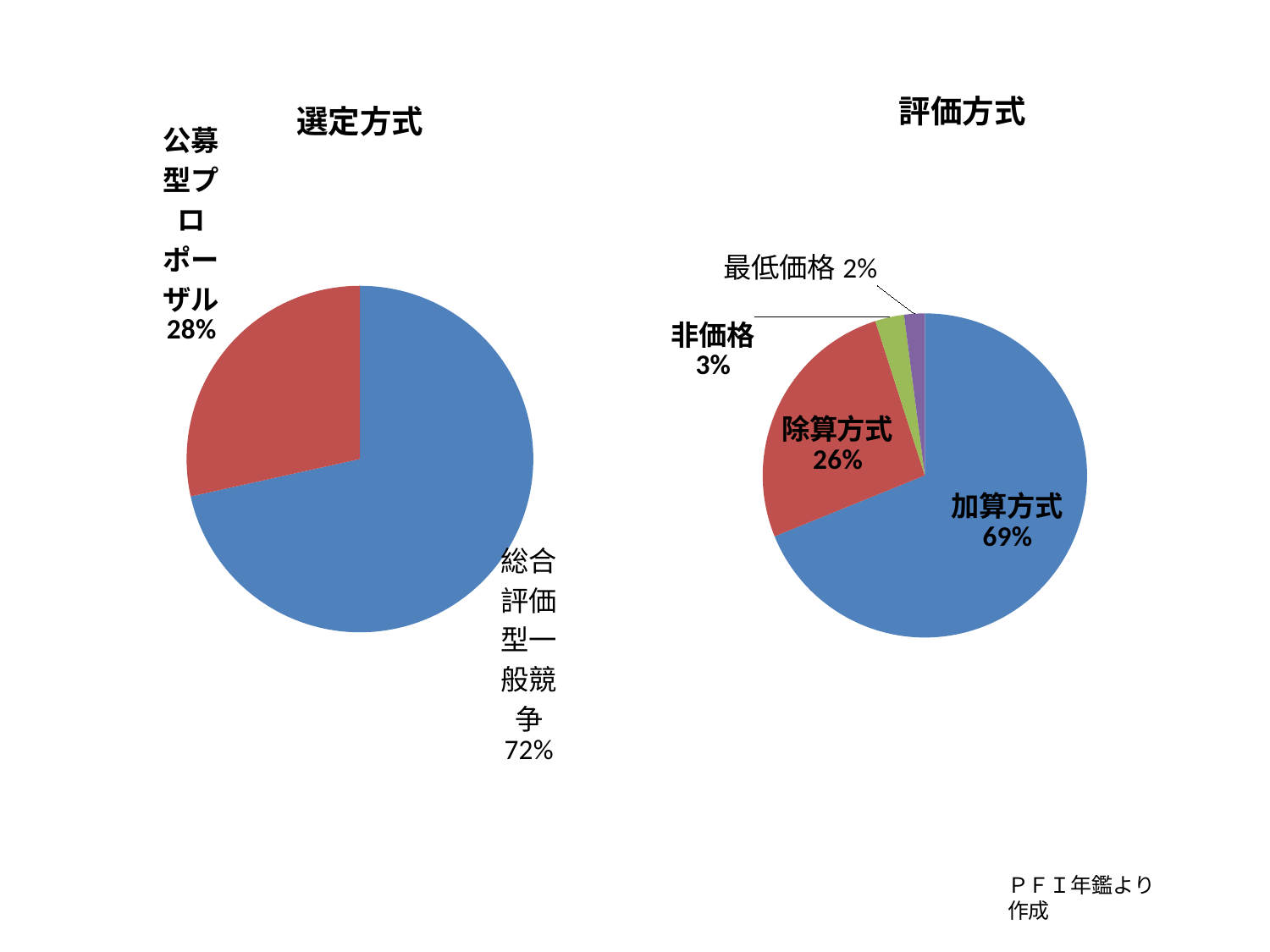
In the 選定方式 chart, how many slices does the pie have? 2 In the 選定方式 chart, what share does 公募型プロポーザル have? 28% What kind of chart is the 評価方式 chart? Pie chart In the 評価方式 chart, what share does 除算方式 have? 26% In the 評価方式 chart, how many slices does the pie have? 4 In the 評価方式 chart, which is larger, 非価格 or 最低価格? 非価格 In the 選定方式 chart, what is the difference between the shares of 総合評価型一般競争 and 公募型プロポーザル? 44% In the 評価方式 chart, what share does 最低価格 have? 2% In the 評価方式 chart, which category has the smallest slice? 最低価格 In the 選定方式 chart, which category has the largest slice? 総合評価型一般競争